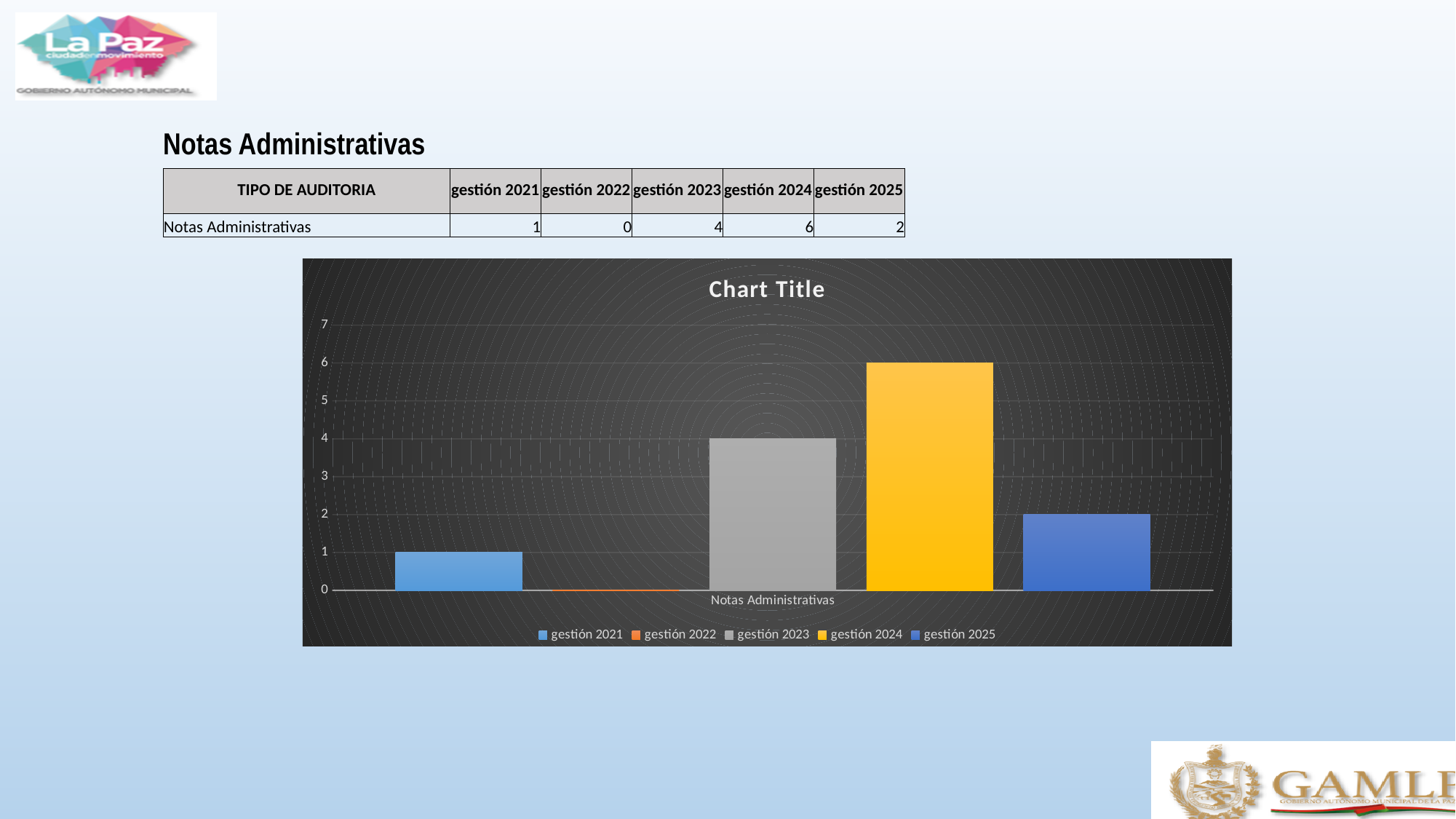
What is the value for gestión 2022 in the chart? 0 Which is larger, the value for gestión 2023 or the value for gestión 2025? gestión 2023 Which series has the highest value in the chart? gestión 2024 What is the title shown on the chart? Chart Title Is the value for gestión 2024 greater or less than 5? greater What is the difference between the values for gestión 2024 and gestión 2025? 4 What is the value for gestión 2023 in the chart? 4 What is the value for gestión 2021 in the chart? 1 What is the value for gestión 2024 in the chart? 6 What kind of chart is shown on the slide? bar chart How many series does the chart legend list? 5 Which series has the lowest value in the chart? gestión 2022